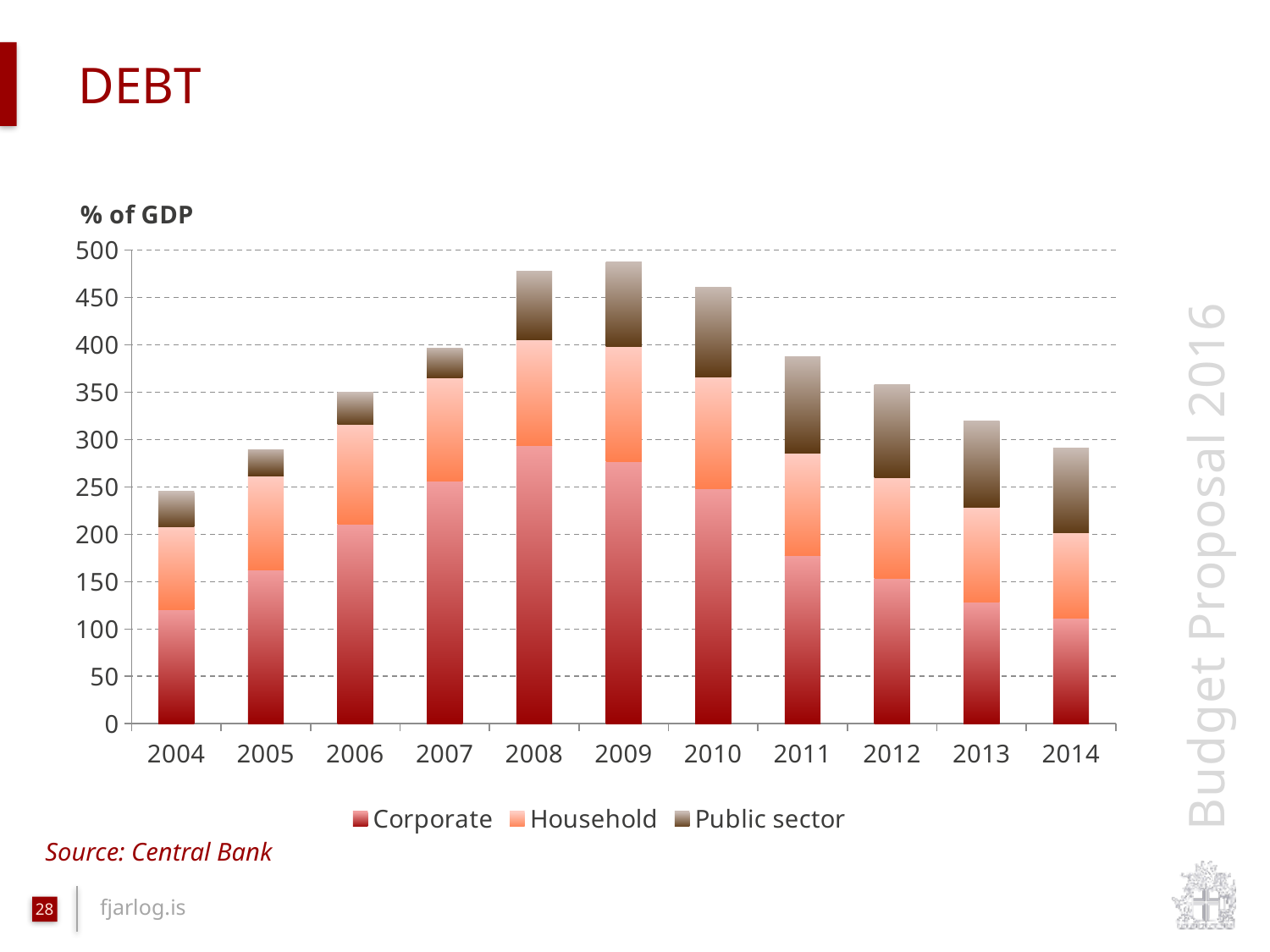
Which year has the highest total debt as % of GDP? 2009 How many series does the legend list? 3 What kind of chart is shown on the slide? Stacked bar chart Which year has the lowest total debt as % of GDP? 2004 Which year has the highest Corporate debt as % of GDP? 2008 Do total debt values rise or fall from 2009 to 2014? fall Is the total debt for 2009 larger or smaller than the total for 2004? larger Is the total debt for 2014 greater or less than 300? less How many years are shown on the x axis? 11 What unit is shown above the y axis of the chart? % of GDP Is the Corporate debt for 2008 greater or less than 250? greater Is the total debt for 2008 greater or less than 450? greater